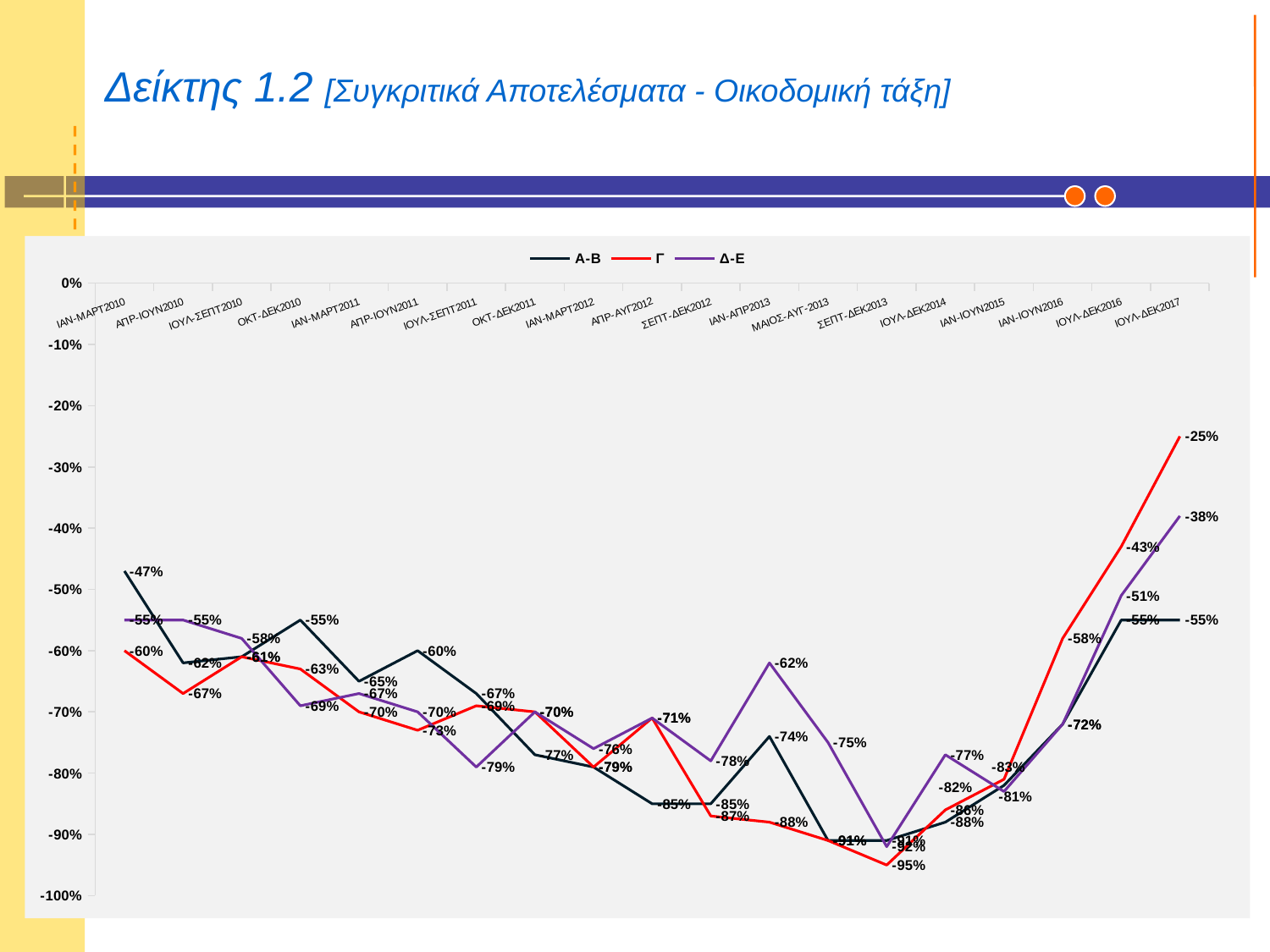
How many periods are shown along the x axis? 19 What is the value of series Γ for ΙΟΥΛ-ΔΕΚ2017? -25% In which period does series Γ reach its lowest value? ΣΕΠΤ-ΔΕΚ2013 Does series Γ rise or fall from ΣΕΠΤ-ΔΕΚ2013 to ΙΟΥΛ-ΔΕΚ2017? Rise What kind of chart is shown on the slide? Line chart What is the value of series Γ for ΣΕΠΤ-ΔΕΚ2013? -95% What is the value of series Δ-Ε for ΙΟΥΛ-ΔΕΚ2017? -38% How many series does the legend list? 3 Which series are listed in the legend? Α-Β, Γ, Δ-Ε What is the difference between series Γ and series Δ-Ε at ΙΟΥΛ-ΔΕΚ2017? 13 percentage points What is the value of series Α-Β for ΙΑΝ-ΜΑΡΤ2010? -47% Which series has the highest value at ΙΟΥΛ-ΔΕΚ2017? Γ